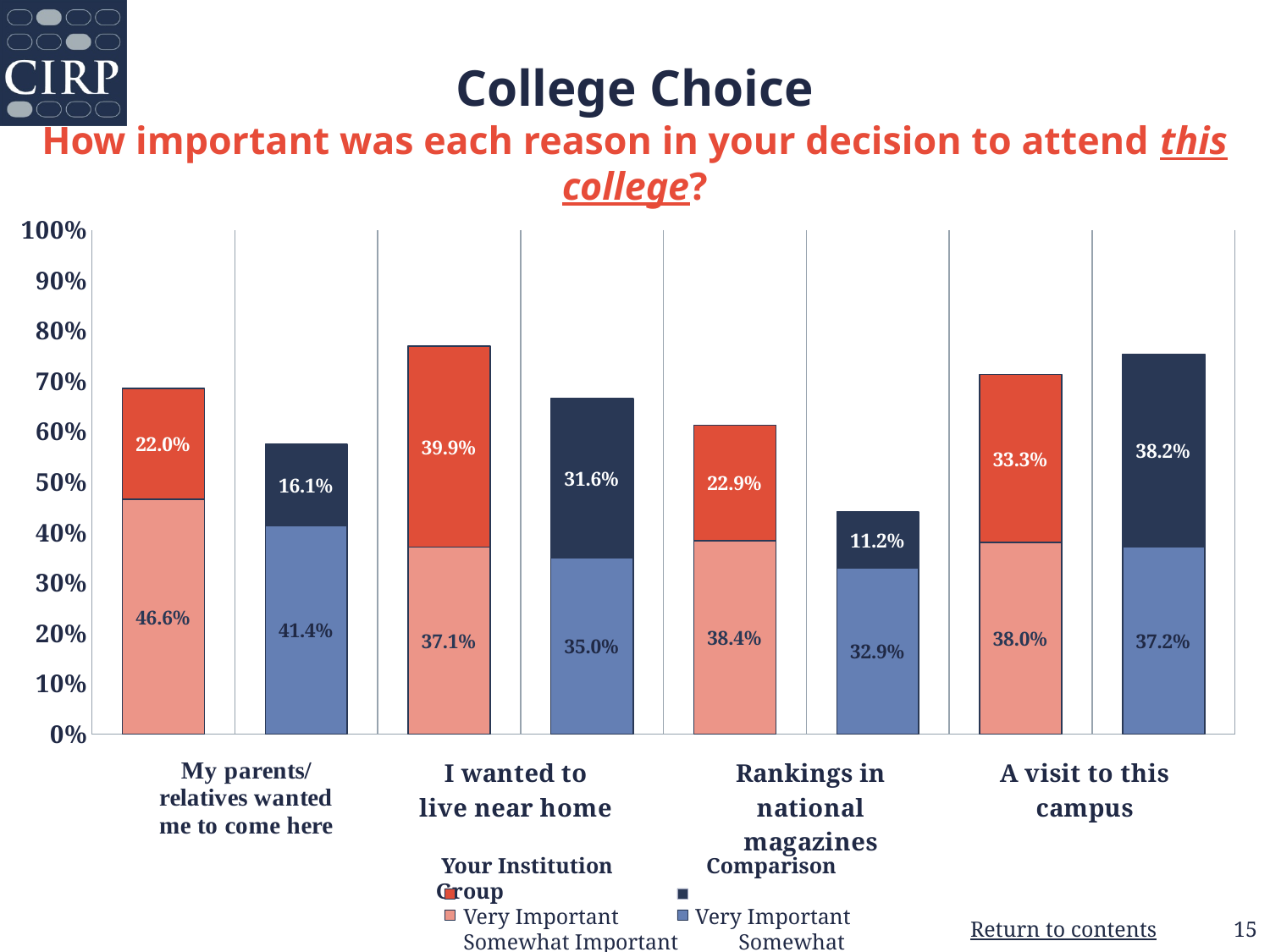
What is the difference between Your Institution and the Comparison Group in the Very Important percentage for "Rankings in national magazines"? 11.7 percentage points What type of chart is shown on the slide? Stacked bar chart What percentage of Your Institution students rated "My parents/relatives wanted me to come here" as Very Important? 22.0% What percentage of the Comparison Group rated "A visit to this campus" as Very Important? 38.2% What percentage of the Comparison Group rated "Rankings in national magazines" as Very Important? 11.2% Which reason has the highest Very Important percentage for Your Institution? I wanted to live near home How many series does the chart's legend list? 4 For "A visit to this campus", which group has the larger Very Important percentage, Your Institution or the Comparison Group? Comparison Group What percentage of Your Institution students rated "I wanted to live near home" as Somewhat Important? 37.1% How many reasons (categories) are shown on the x axis of the chart? 4 What is the combined Very Important and Somewhat Important percentage for Your Institution for "I wanted to live near home"? 77.0% Which reason has the lowest Very Important percentage for the Comparison Group? Rankings in national magazines